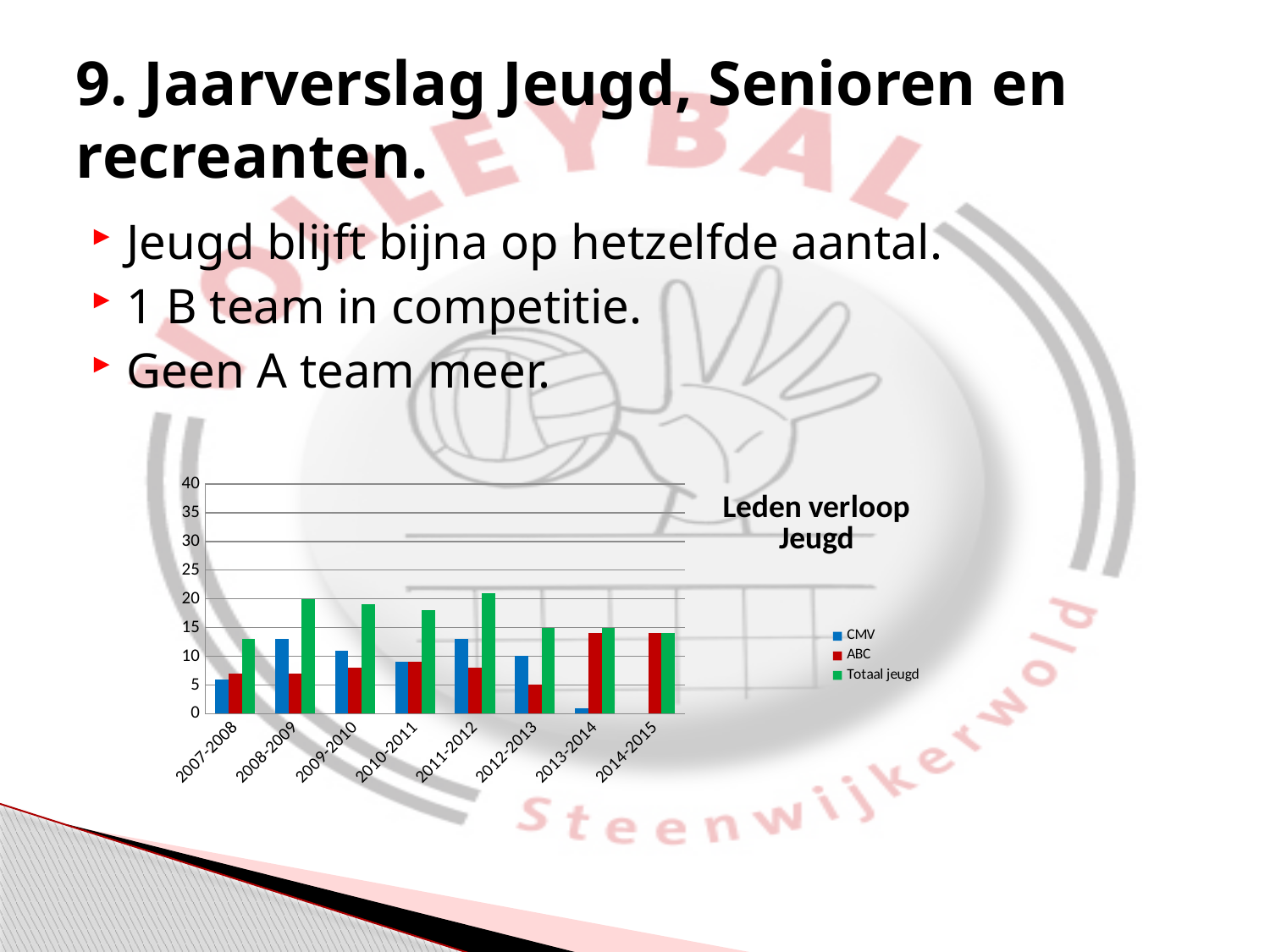
Is the value for CMV in 2013-2014 greater or less than 5? less Which colour represents the Totaal jeugd series in the chart? green Which is larger: ABC in 2013-2014 or ABC in 2007-2008? ABC in 2013-2014 What is the title of the chart? Leden verloop Jeugd Is the value for CMV in 2008-2009 greater or less than 10? greater How many seasons (categories) are shown on the x axis of the chart? 8 What kind of chart is shown on the slide? bar chart Is the value for ABC in 2013-2014 greater or less than 10? greater In 2008-2009, which is larger: CMV or ABC? CMV How many series does the legend of the chart list? 3 What is the value for Totaal jeugd in 2008-2009? 20